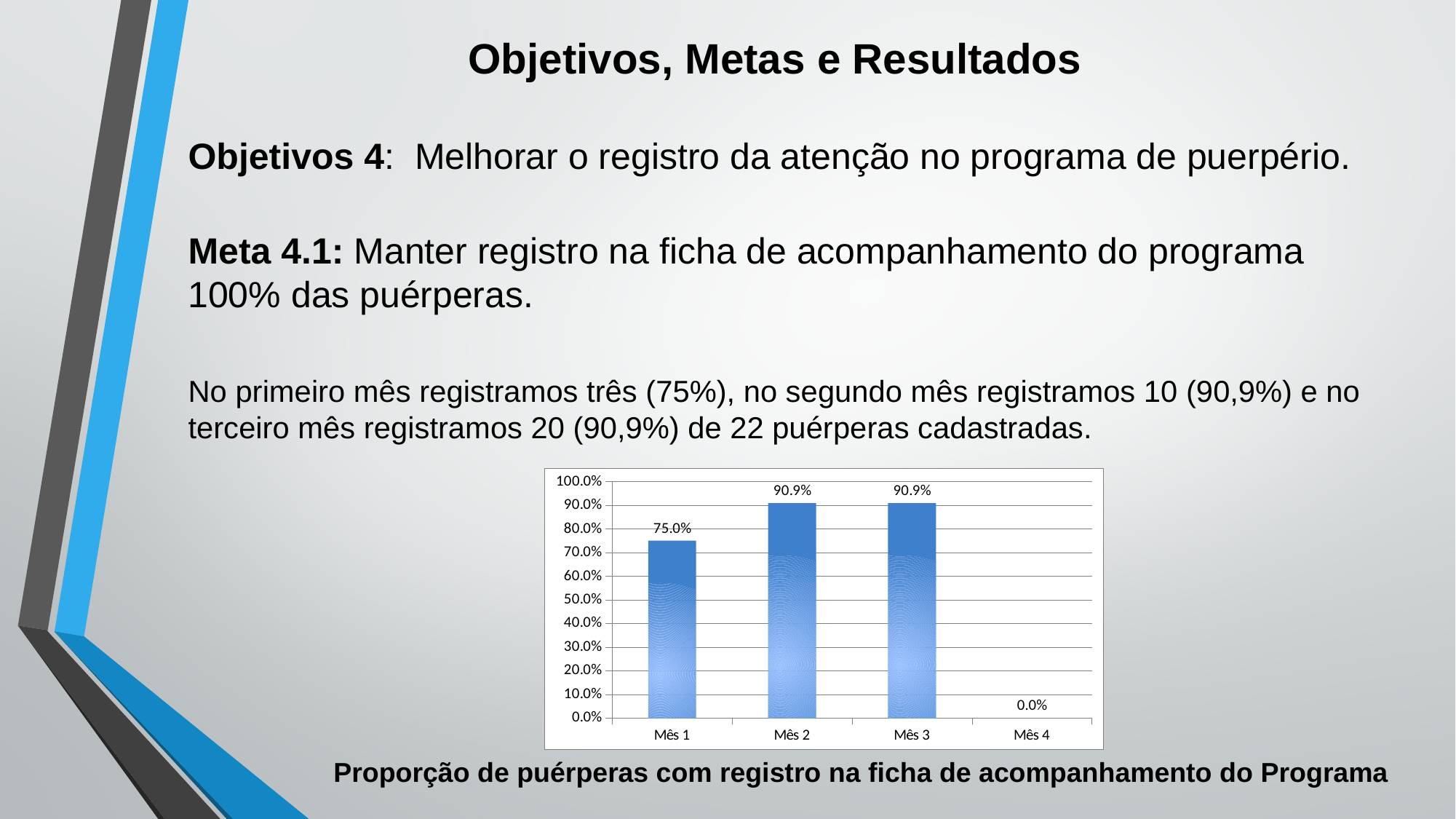
Which is larger, the value for Mês 1 or the value for Mês 3? Mês 3 What is the title printed below the chart? Proporção de puérperas com registro na ficha de acompanhamento do Programa Is the value for Mês 1 greater or less than 70.0%? greater Does the value rise or fall from Mês 1 to Mês 2? rise What is the value for Mês 4? 0.0% How many months are shown on the x axis? 4 What is the value for Mês 2? 90.9% What kind of chart is shown on the slide? bar chart What is the difference between the values for Mês 2 and Mês 1? 15.9% Which month has the lowest value? Mês 4 Does the value rise or fall from Mês 3 to Mês 4? fall What is the value for Mês 1? 75.0%